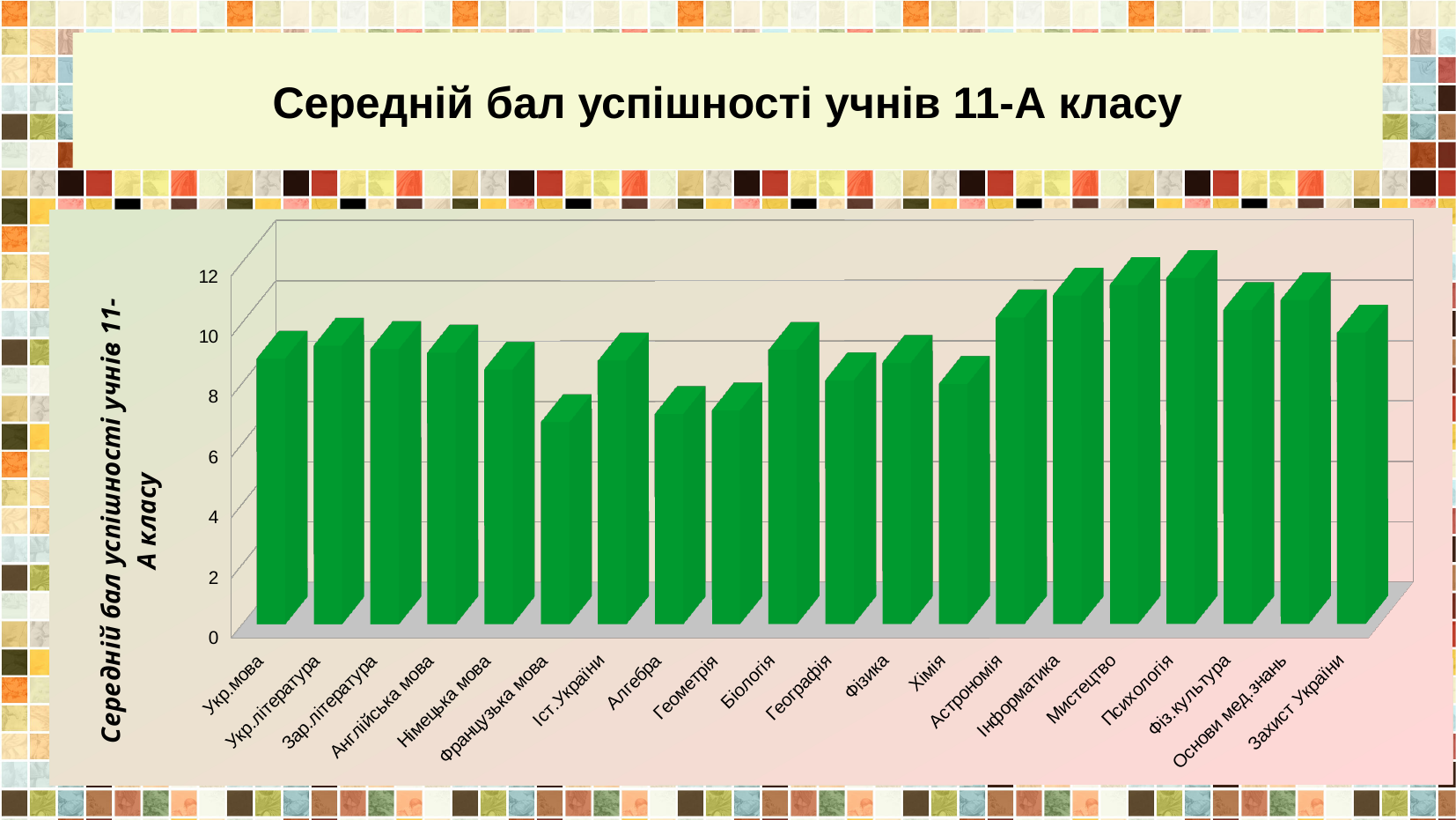
What colour are the bars in the chart? green What kind of chart is shown on the slide? bar chart Is the value for Алгебра greater or less than 8? less Which subject has the lowest average score on the chart? Французька мова Is the value for Укр.мова greater or less than 10? less What is the title of the slide's chart? Середній бал успішності учнів 11-А класу Is the value for Мистецтво greater or less than 10? greater Which is larger, the value for Інформатика or the value for Алгебра? Інформатика Which subject has the highest average score on the chart? Психологія How many subjects (categories) are plotted on the chart? 20